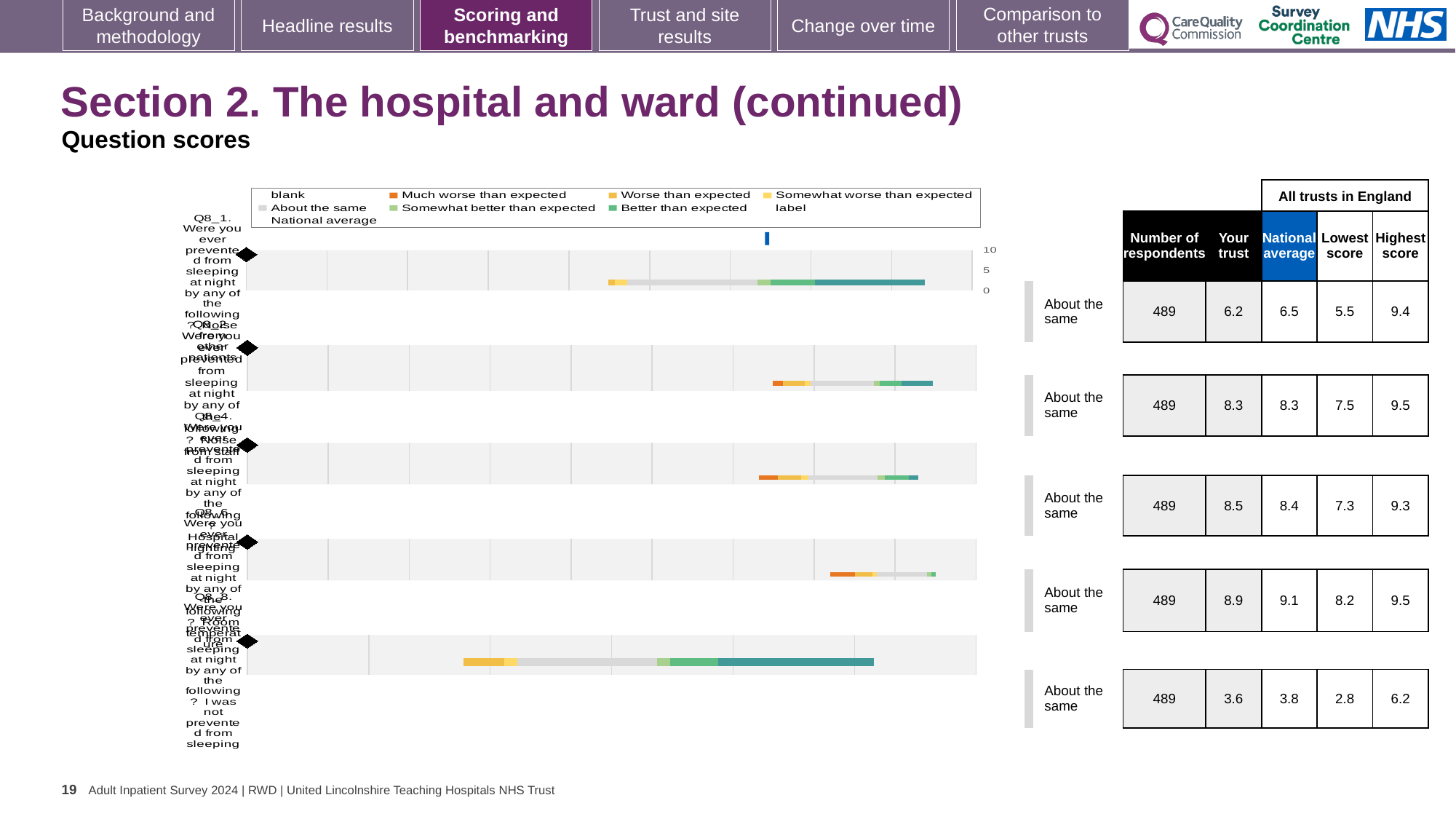
For the first row (Q8_1), what is the difference between the highest score and the lowest score across all trusts in England? 3.9 For the last row (Q8_8), how much higher is the national average than the 'Your trust' score? 0.2 What kind of chart is shown on the slide? bar chart What benchmark category is shown next to every question row in the chart? About the same How many respondents are listed for each question row? 489 Which legend entry is shown in dark orange? Much worse than expected What is the national average for the last row, Q8_8 (I was not prevented from sleeping)? 3.8 Which question row has the lowest 'Your trust' score? Q8_8 (fifth row), 3.6 For the third row (Q8_4), which is larger: the 'Your trust' score or the national average? Your trust (8.5) What is the 'Your trust' score for the first row, Q8_1 (noise from other patients)? 6.2 How many question rows (bars) are plotted in the chart? 5 Which question row has the highest 'Your trust' score? Q8_6 (fourth row), 8.9